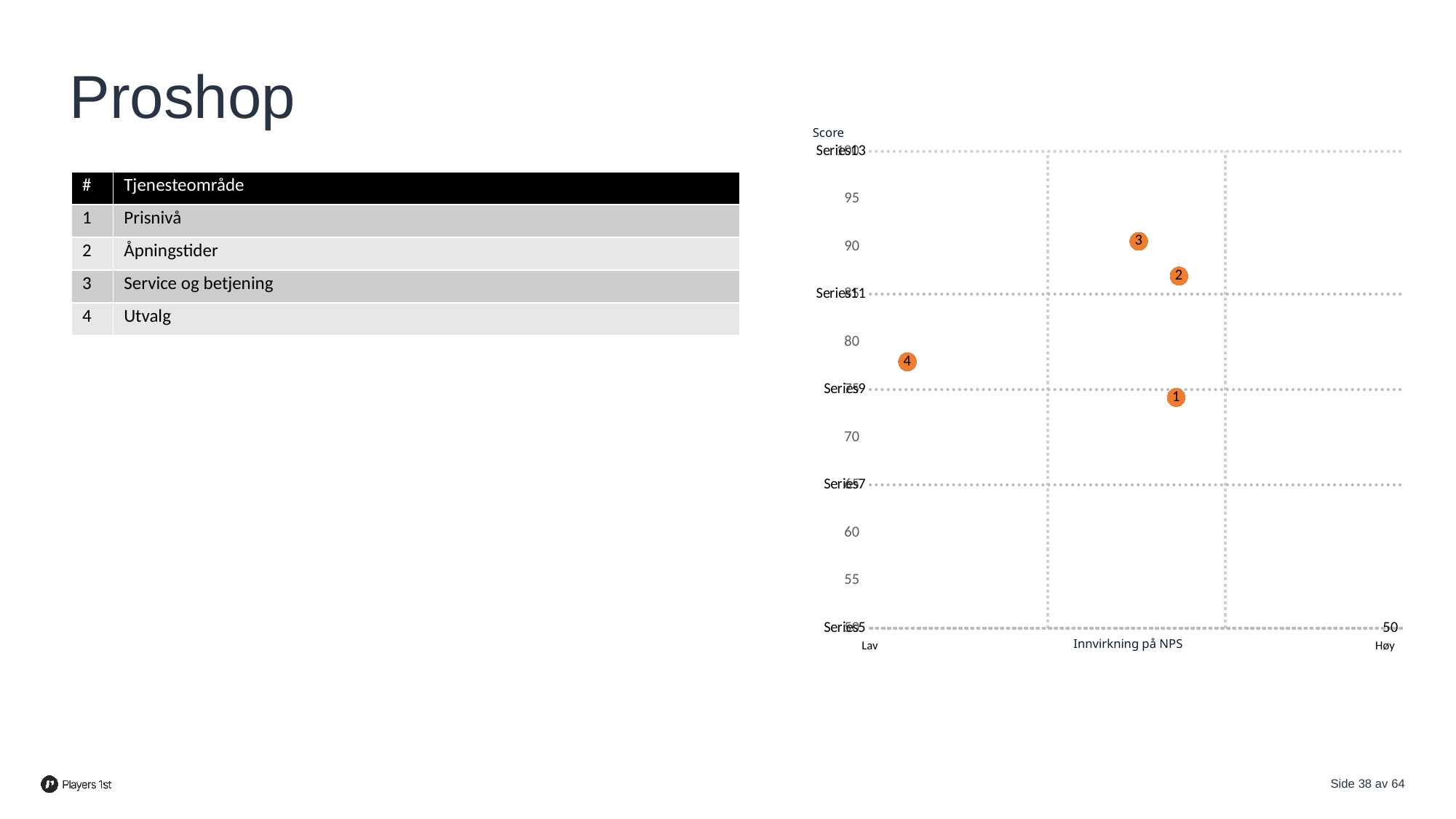
What is the label of the vertical axis of the chart? Score Is the Score for point 3 greater or less than 85? greater What kind of chart is shown on the slide? scatter chart Which point is furthest to the left on the 'Innvirkning på NPS' axis? 4 Is the Score for point 1 greater or less than 75? less Which numbered point has the highest Score on the chart? 3 Is the Score for point 2 greater or less than 90? less How many data points are plotted on the chart? 4 Which numbered point has the lowest Score on the chart? 1 Which has the higher Score, point 2 or point 4? point 2